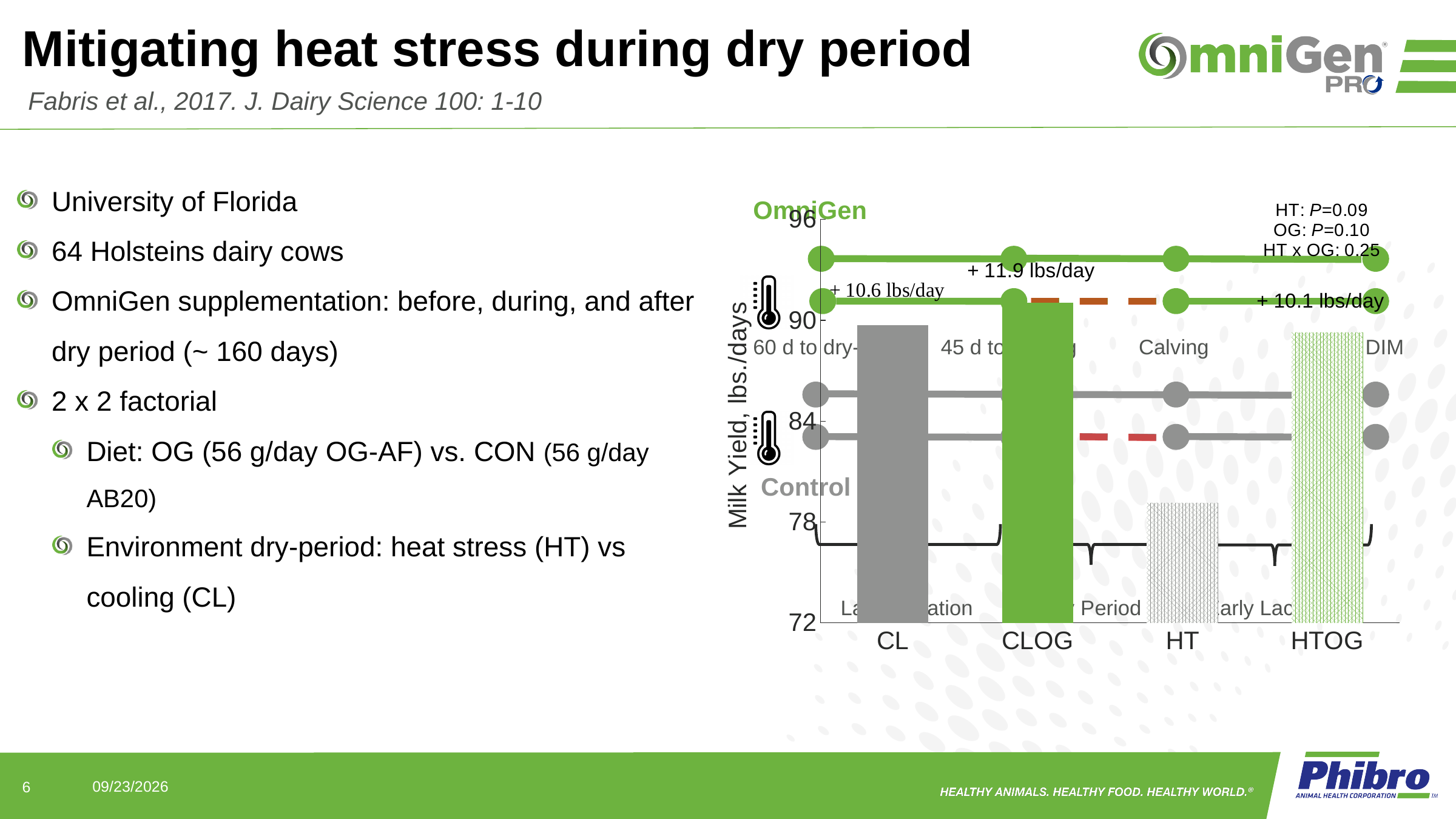
Which category has the lowest milk yield in the chart? HT Is the milk yield for HTOG greater or less than 84? greater What is the label of the y axis of the chart? Milk Yield, lbs./days Is the milk yield for CLOG greater or less than 90? greater Is the milk yield for HT greater or less than 78? greater Which category has the highest milk yield in the chart? CLOG Which has the larger milk yield, CL or HT? CL What kind of chart is shown on the slide? bar chart How many categories are shown on the x axis of the chart? 4 Which has the larger milk yield, CLOG or HTOG? CLOG